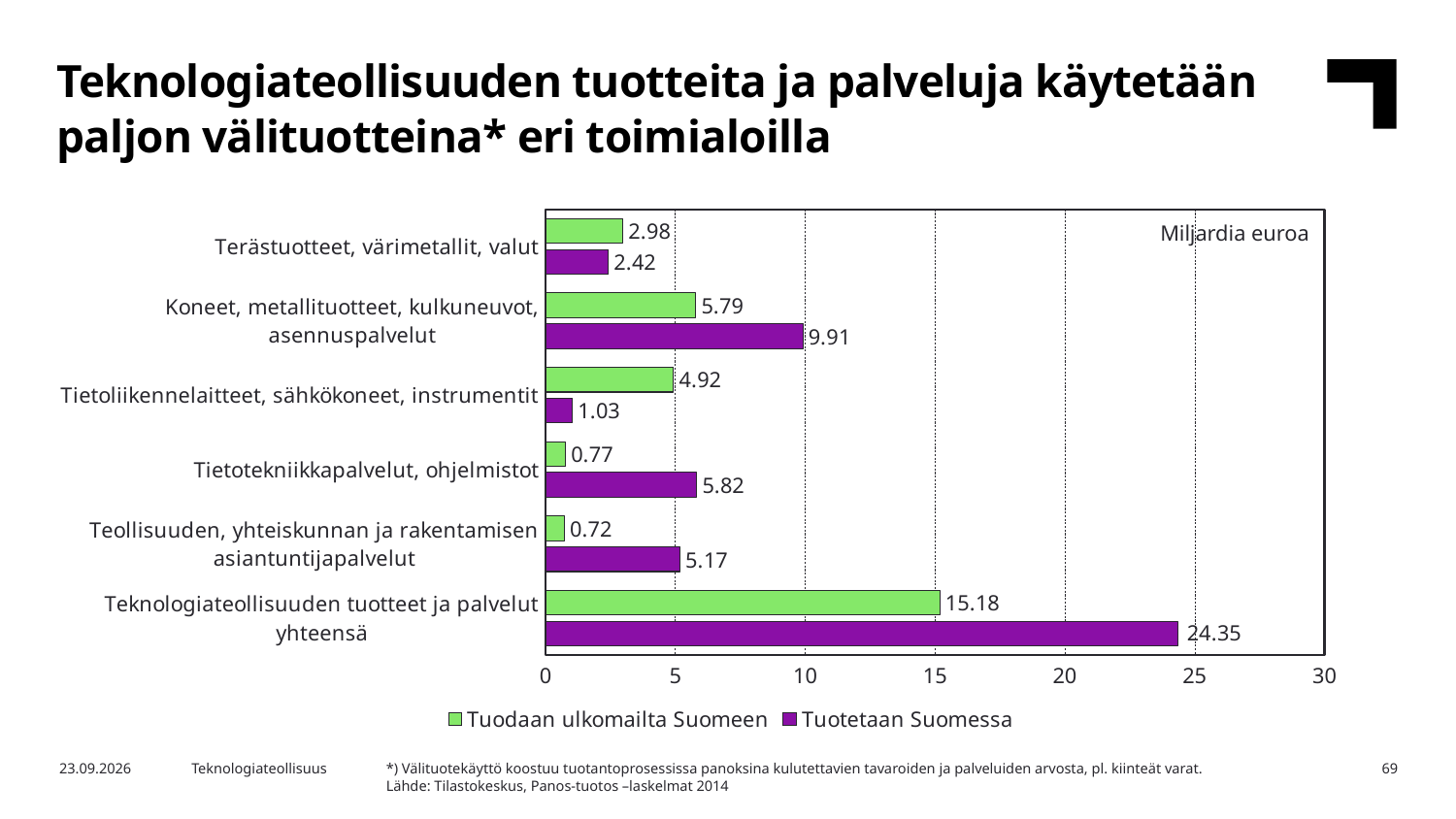
How many series does the legend list? 2 What is the value of 'Tuotetaan Suomessa' for 'Teknologiateollisuuden tuotteet ja palvelut yhteensä'? 24.35 Which category has the lowest value for 'Tuodaan ulkomailta Suomeen'? Teollisuuden, yhteiskunnan ja rakentamisen asiantuntijapalvelut Is the value of 'Tuodaan ulkomailta Suomeen' for 'Teknologiateollisuuden tuotteet ja palvelut yhteensä' greater or less than 15? greater What kind of chart is shown on the slide? Bar chart What unit is indicated in the top right corner of the chart? Miljardia euroa For 'Terästuotteet, värimetallit, valut', which is larger: 'Tuodaan ulkomailta Suomeen' or 'Tuotetaan Suomessa'? Tuodaan ulkomailta Suomeen What is the value of 'Tuodaan ulkomailta Suomeen' for 'Tietoliikennelaitteet, sähkökoneet, instrumentit'? 4.92 What is the difference between 'Tuotetaan Suomessa' and 'Tuodaan ulkomailta Suomeen' for 'Tietotekniikkapalvelut, ohjelmistot'? 5.05 Excluding the total row, which category has the highest value for 'Tuotetaan Suomessa'? Koneet, metallituotteet, kulkuneuvot, asennuspalvelut What is the value of 'Tuotetaan Suomessa' for 'Koneet, metallituotteet, kulkuneuvot, asennuspalvelut'? 9.91 How many categories are shown on the chart? 6